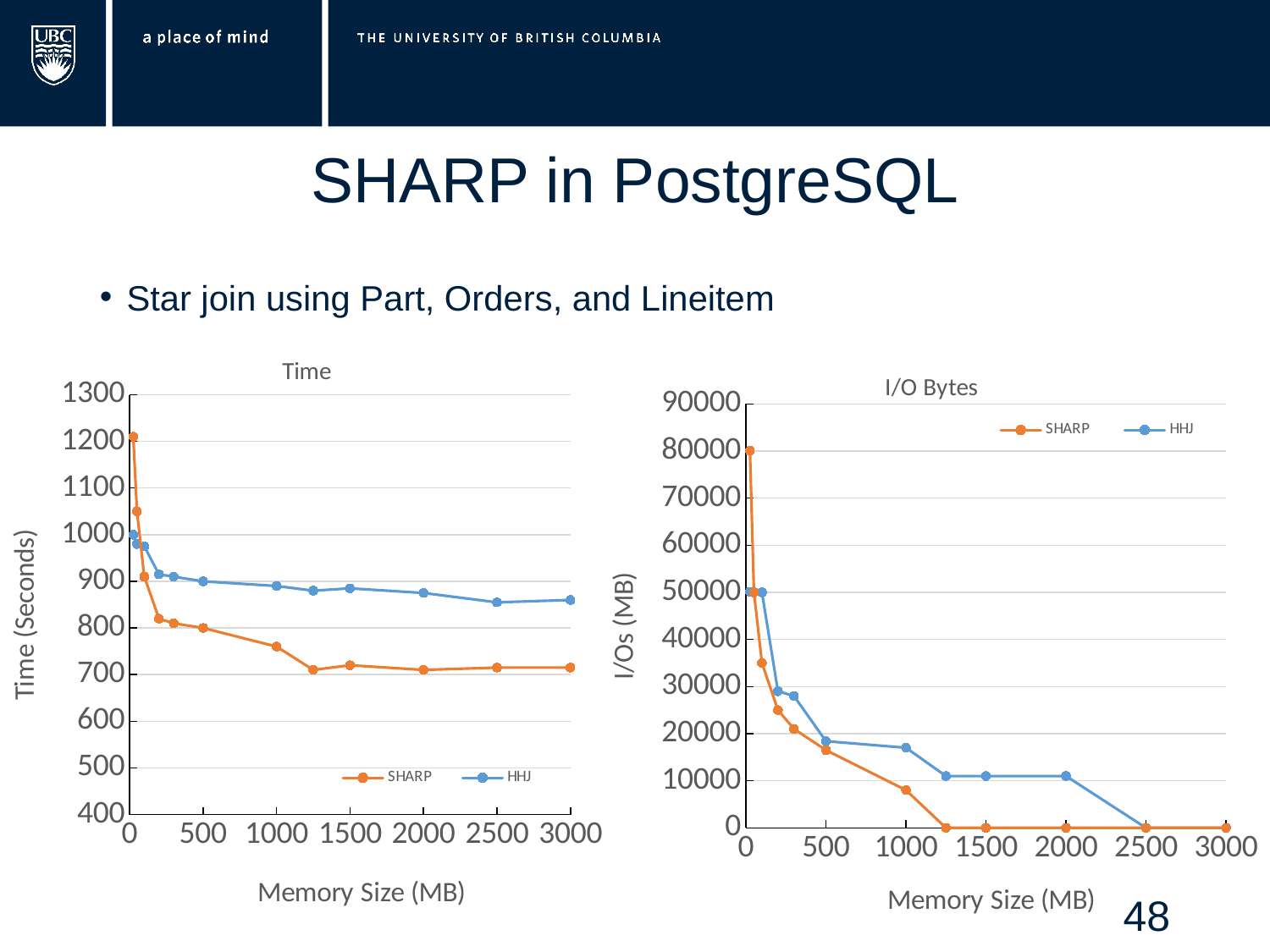
What is the x-axis label of the "I/O Bytes" chart? Memory Size (MB) In the "I/O Bytes" chart, which series has the larger value at memory size 1000, SHARP or HHJ? HHJ What are the two series named in the legend of the "Time" chart? SHARP and HHJ In the "Time" chart, is the value for HHJ at memory size 3000 greater or less than 800? greater In the "Time" chart, which series has the larger value at memory size 3000, SHARP or HHJ? HHJ In the "Time" chart, is the value for SHARP at memory size 3000 greater or less than 800? less How many series does the legend of the "I/O Bytes" chart list? 2 In the "I/O Bytes" chart, do the SHARP values rise or fall as memory size increases? fall In the "I/O Bytes" chart, is the value for HHJ at memory size 1000 greater or less than 20000? less What kind of chart is the chart titled "Time"? line chart